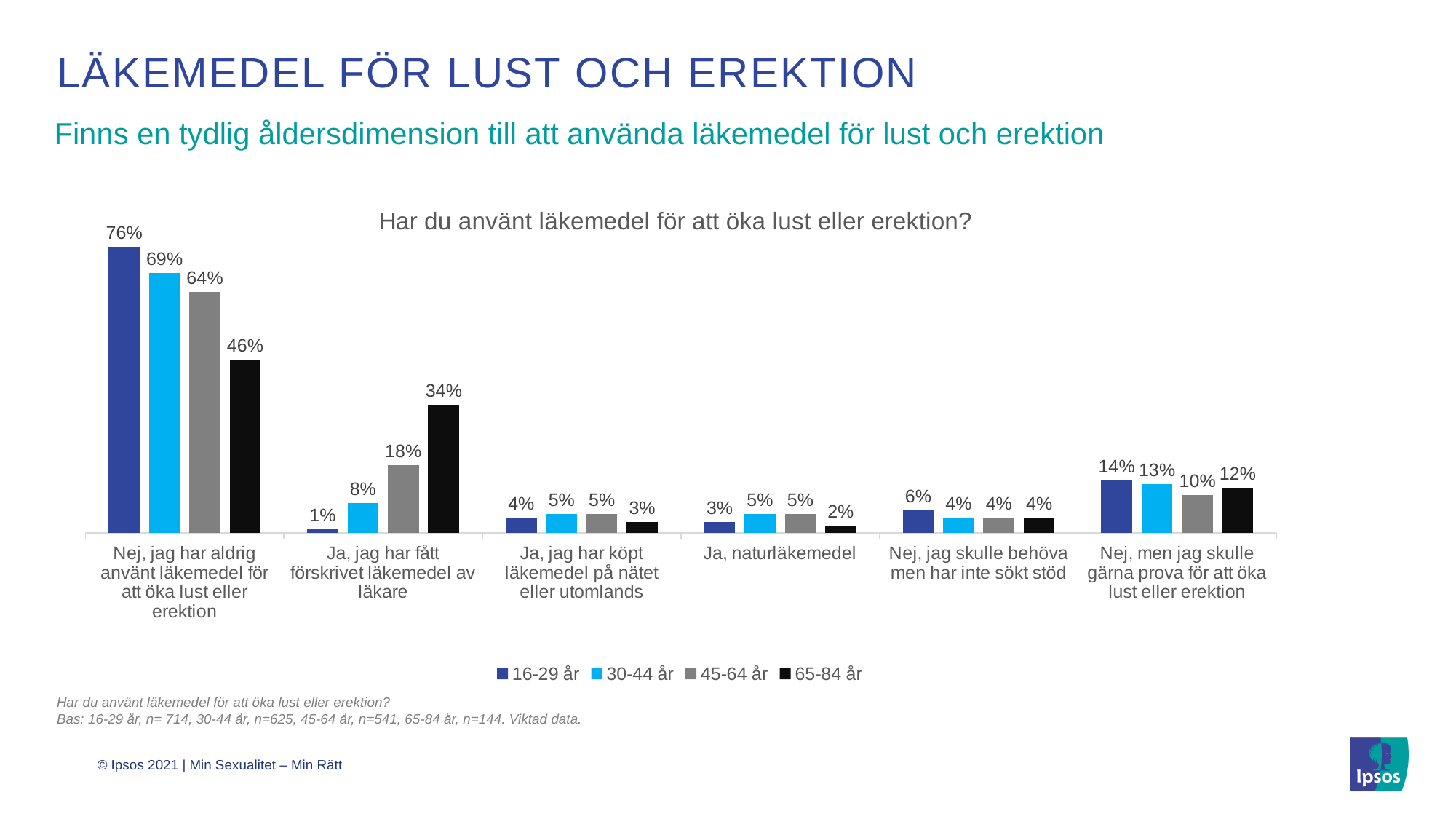
Which colour represents the 65-84 år series in the chart? Black What is the value for the 45-64 år series in the category "Nej, men jag skulle gärna prova för att öka lust eller erektion"? 10% Which is larger in the category "Ja, naturläkemedel": the value for 16-29 år or the value for 30-44 år? 30-44 år What is the title of the chart? Har du använt läkemedel för att öka lust eller erektion? Which age group has the highest value in the category "Ja, jag har fått förskrivet läkemedel av läkare"? 65-84 år What is the difference between the 16-29 år and 65-84 år values in the category "Nej, jag har aldrig använt läkemedel för att öka lust eller erektion"? 30 percentage points What is the value for the 16-29 år series in the category "Nej, jag har aldrig använt läkemedel för att öka lust eller erektion"? 76% Which age group has the lowest value in the category "Nej, jag har aldrig använt läkemedel för att öka lust eller erektion"? 65-84 år How many series does the legend list? 4 How many response categories are shown on the x axis? 6 What is the value for the 65-84 år series in the category "Ja, jag har fått förskrivet läkemedel av läkare"? 34% What kind of chart is shown on the slide? Bar chart